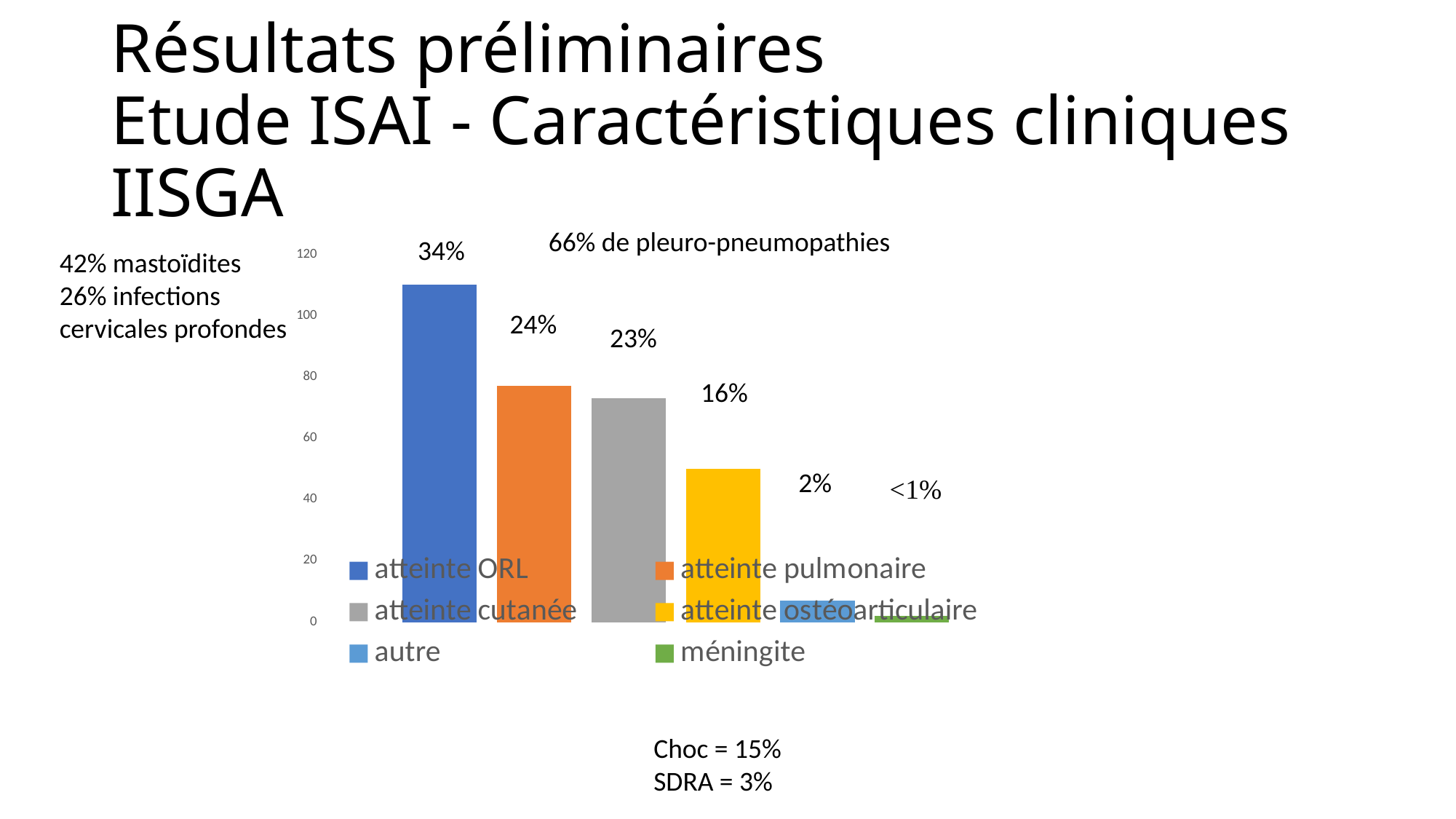
Is the bar for autre greater or less than 20 on the y axis? less What percentage is shown above the bar for atteinte ORL? 34% How many entries does the legend list? 6 Is the bar for atteinte ORL greater or less than 100 on the y axis? greater What percentage is shown above the bar for atteinte pulmonaire? 24% What kind of chart is shown on the slide? bar chart Which has the larger percentage, atteinte pulmonaire or atteinte cutanée? atteinte pulmonaire Which category has the tallest bar? atteinte ORL What percentage is shown above the bar for atteinte ostéoarticulaire? 16% What is the difference in percentage between atteinte ORL and atteinte ostéoarticulaire? 18% What percentage is shown for méningite? <1% Which category has the shortest bar? méningite